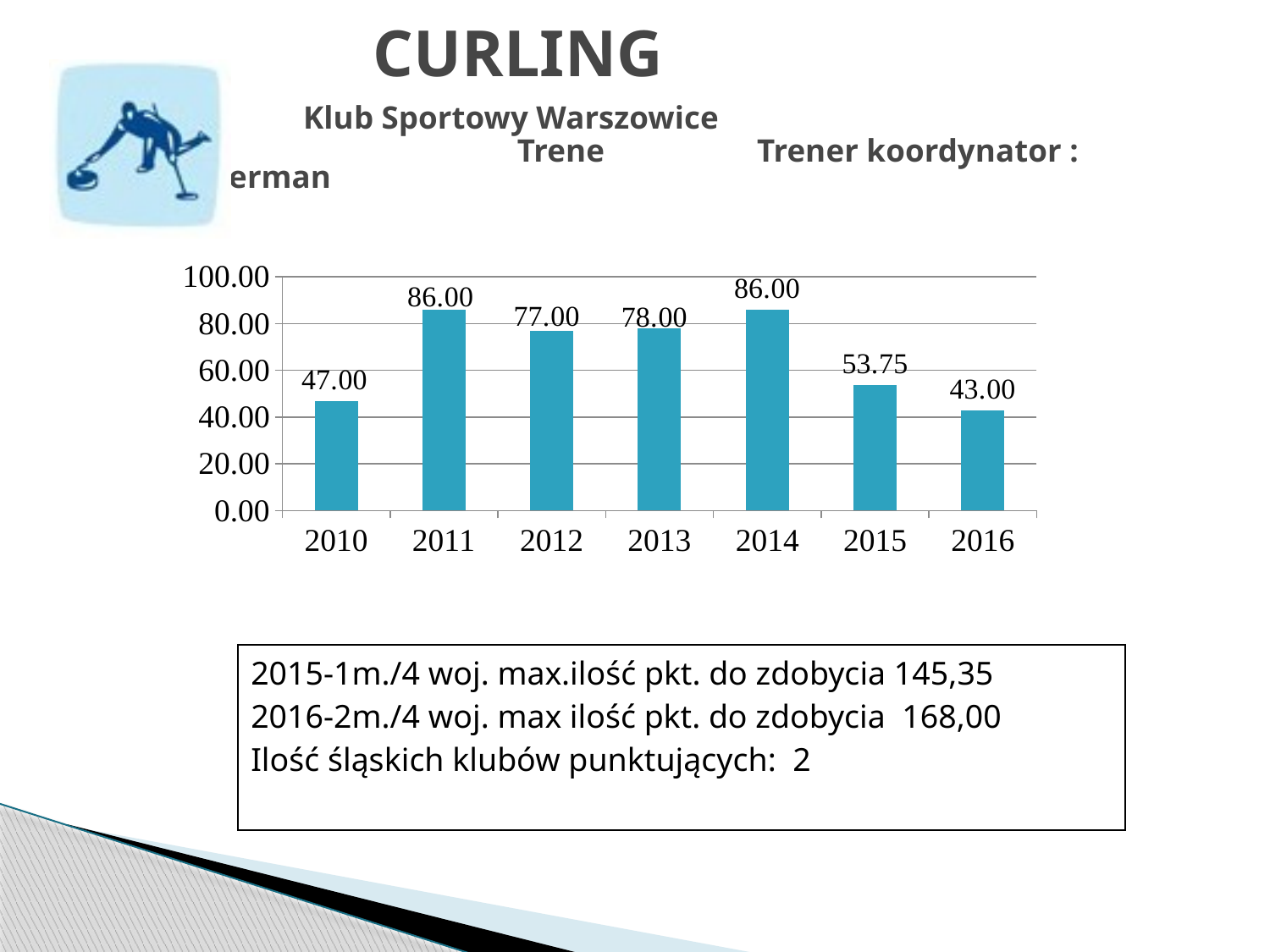
Is the value for 2014 greater or less than 80.00? greater Which year has the lowest value? 2016 Do the values rise or fall from 2014 to 2016? fall What is the difference between the values for 2014 and 2015? 32.25 What is the difference between the values for 2011 and 2010? 39.00 What is the value for 2013? 78.00 What is the value for 2016? 43.00 What is the value for 2010? 47.00 What kind of chart is shown on the slide? bar chart How many years are shown on the x axis? 7 What is the value for 2015? 53.75 Which is larger, the value for 2012 or the value for 2015? 2012